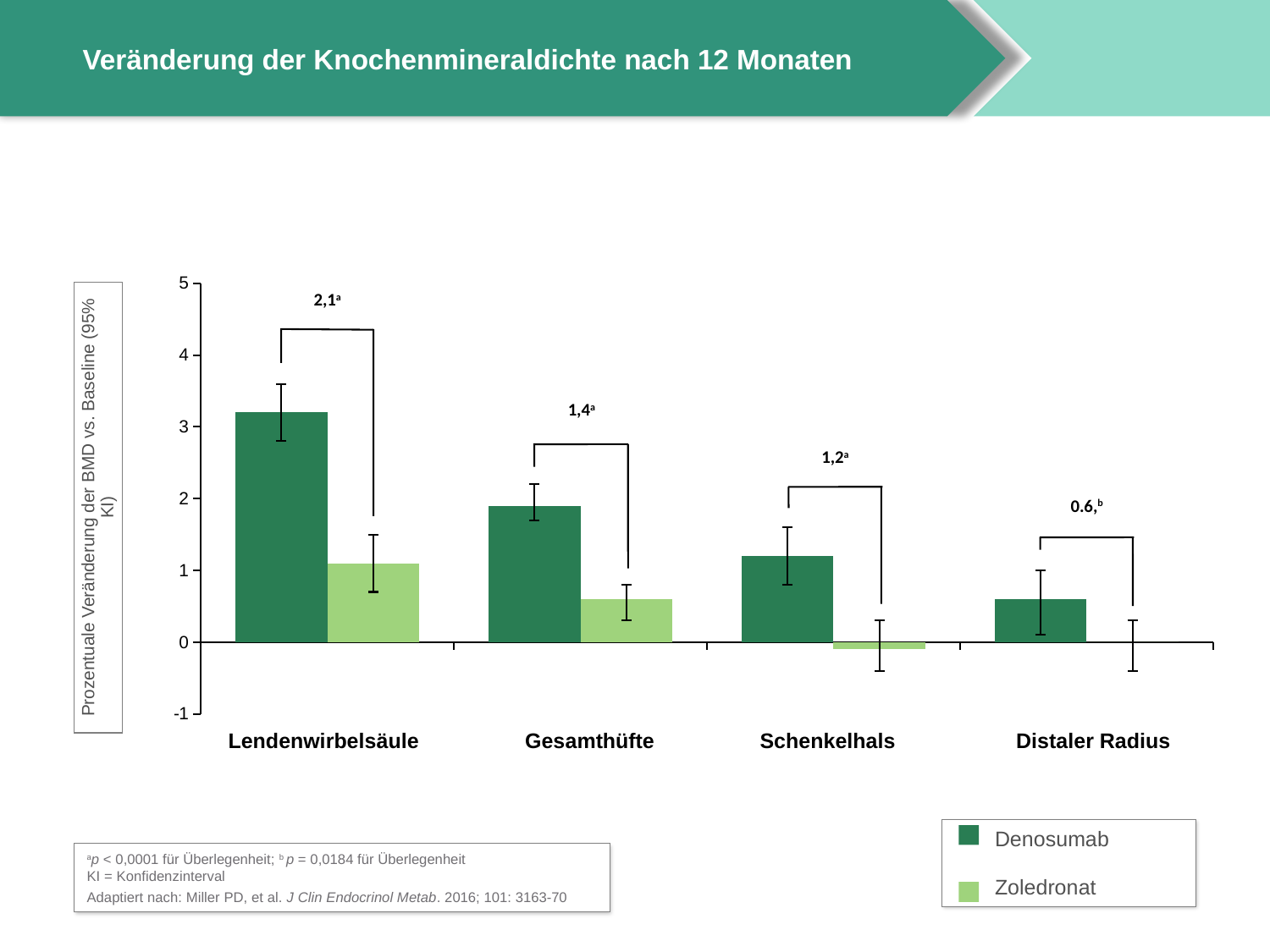
For which category is the Denosumab bar the lowest? Distaler Radius How many categories are shown on the x axis? 4 Which series is shown in the lighter green colour? Zoledronat What kind of chart is shown on the slide? bar chart Is the Denosumab value for Lendenwirbelsäule greater or less than 3? greater Do the Denosumab values rise or fall from Lendenwirbelsäule to Distaler Radius? fall What difference value is printed above the bracket for Lendenwirbelsäule? 2,1 How many series does the legend list? 2 What difference value is printed above the bracket for Schenkelhals? 1,2 What is the title of the chart? Veränderung der Knochenmineraldichte nach 12 Monaten For which category is the Denosumab bar the highest? Lendenwirbelsäule What difference value is printed above the bracket for Gesamthüfte? 1,4